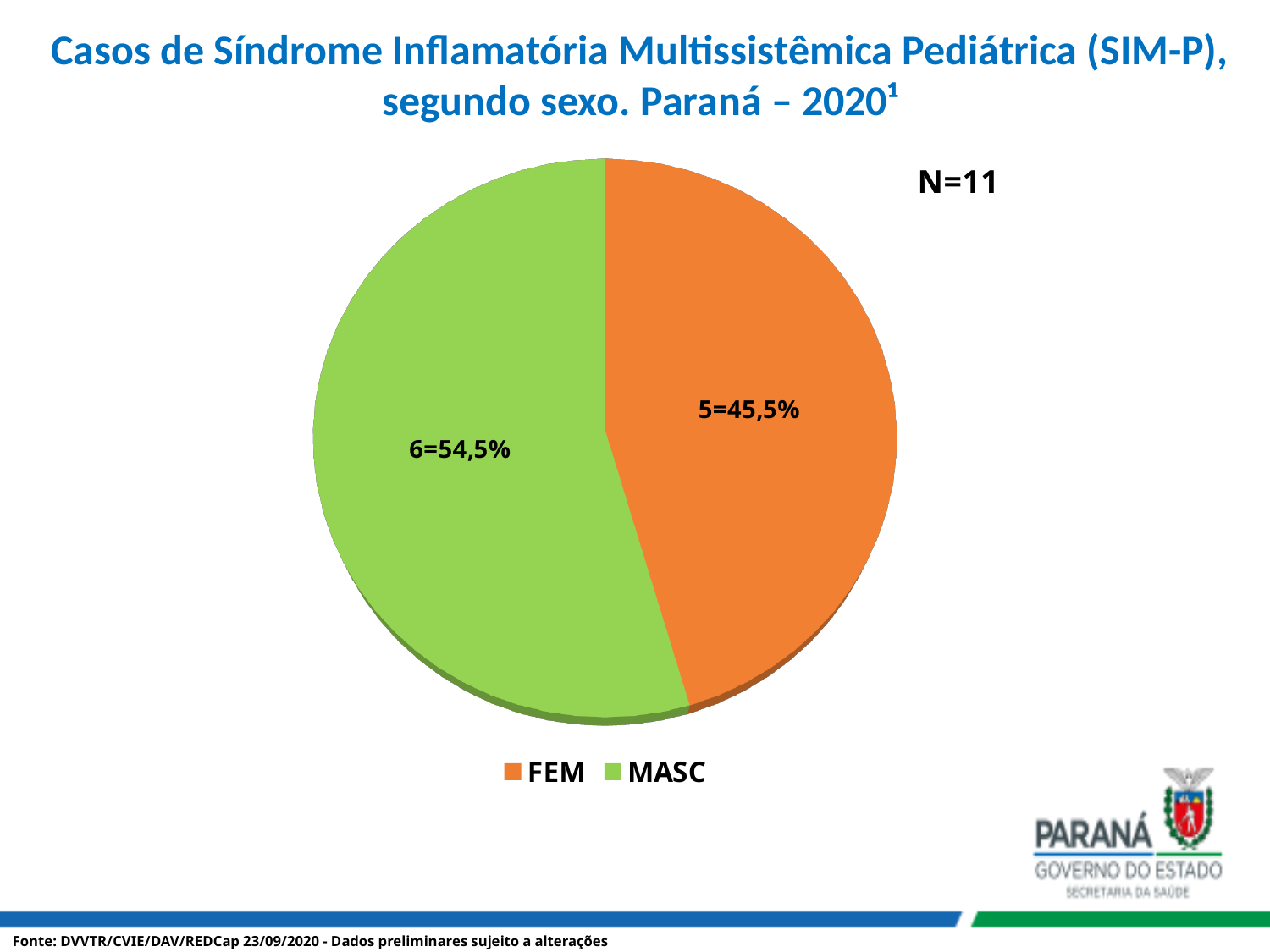
What is the difference in number of cases between MASC and FEM? 1 What kind of chart is shown on the slide? pie chart What is the total number of cases (N) shown on the slide? 11 Which category has the larger slice, FEM or MASC? MASC How many cases does the FEM slice represent? 5 Which category has the smallest slice? FEM How many cases does the MASC slice represent? 6 What colour is the FEM slice? orange How many slices does the pie chart have? 2 What percentage share of the pie is the MASC slice? 54,5% What percentage share of the pie is the FEM slice? 45,5% What colour is the MASC slice? green